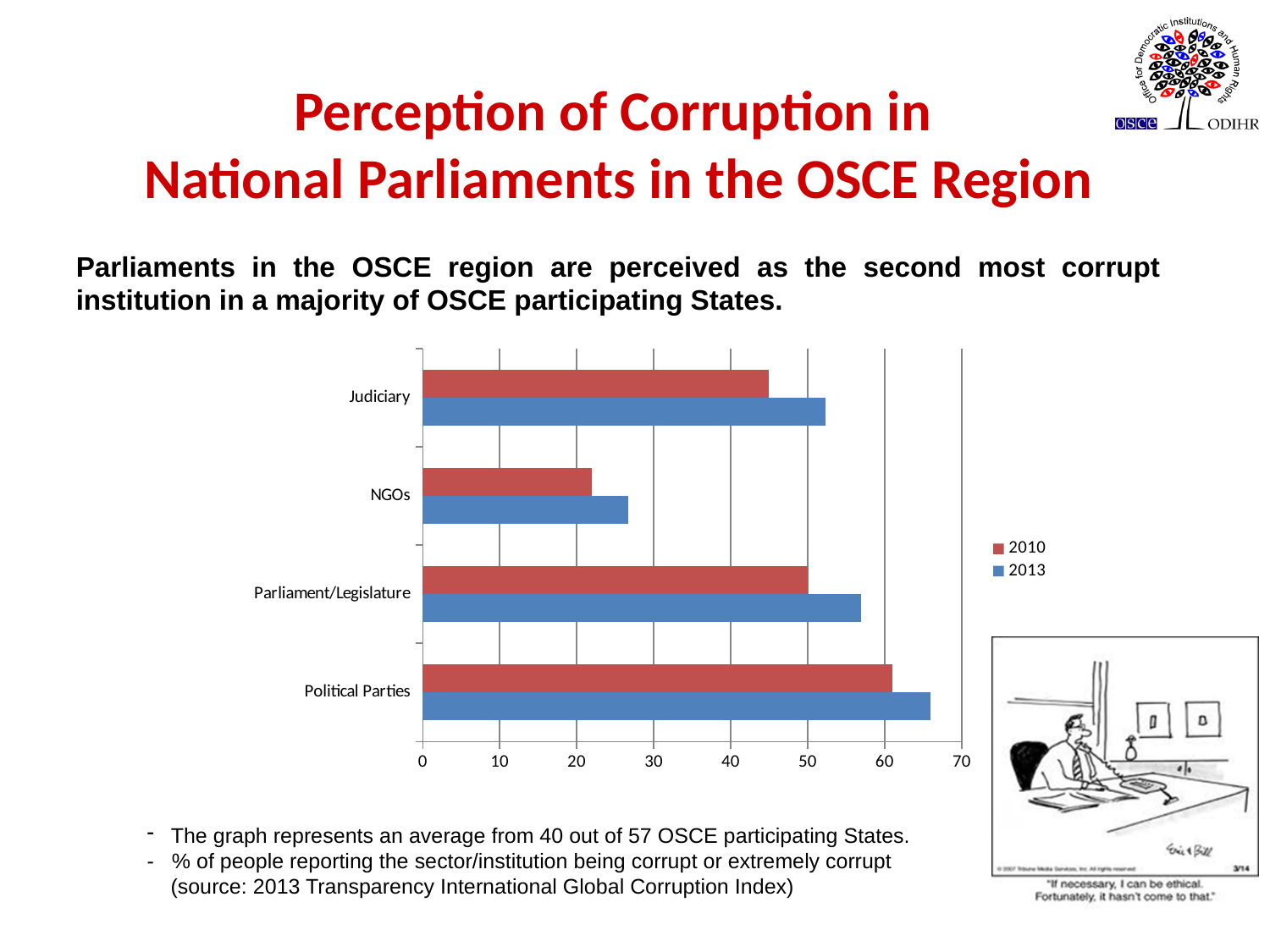
Is the 2013 value for Political Parties greater or less than 60? greater Is the 2013 value for Judiciary greater or less than 50? greater What kind of chart is shown on the slide? Bar chart How many categories (institutions) are shown on the chart? 4 Which institution has the lowest value for 2010? NGOs Which institution has the highest value for 2013? Political Parties How many series does the chart's legend list? 2 Is the 2010 value for NGOs greater or less than 30? less Which is larger: the 2013 value for Judiciary or the 2013 value for Parliament/Legislature? Parliament/Legislature Which institution has the lowest value for 2013? NGOs Which colour represents the 2010 series in the chart? Red For Parliament/Legislature, which year has the larger value, 2010 or 2013? 2013